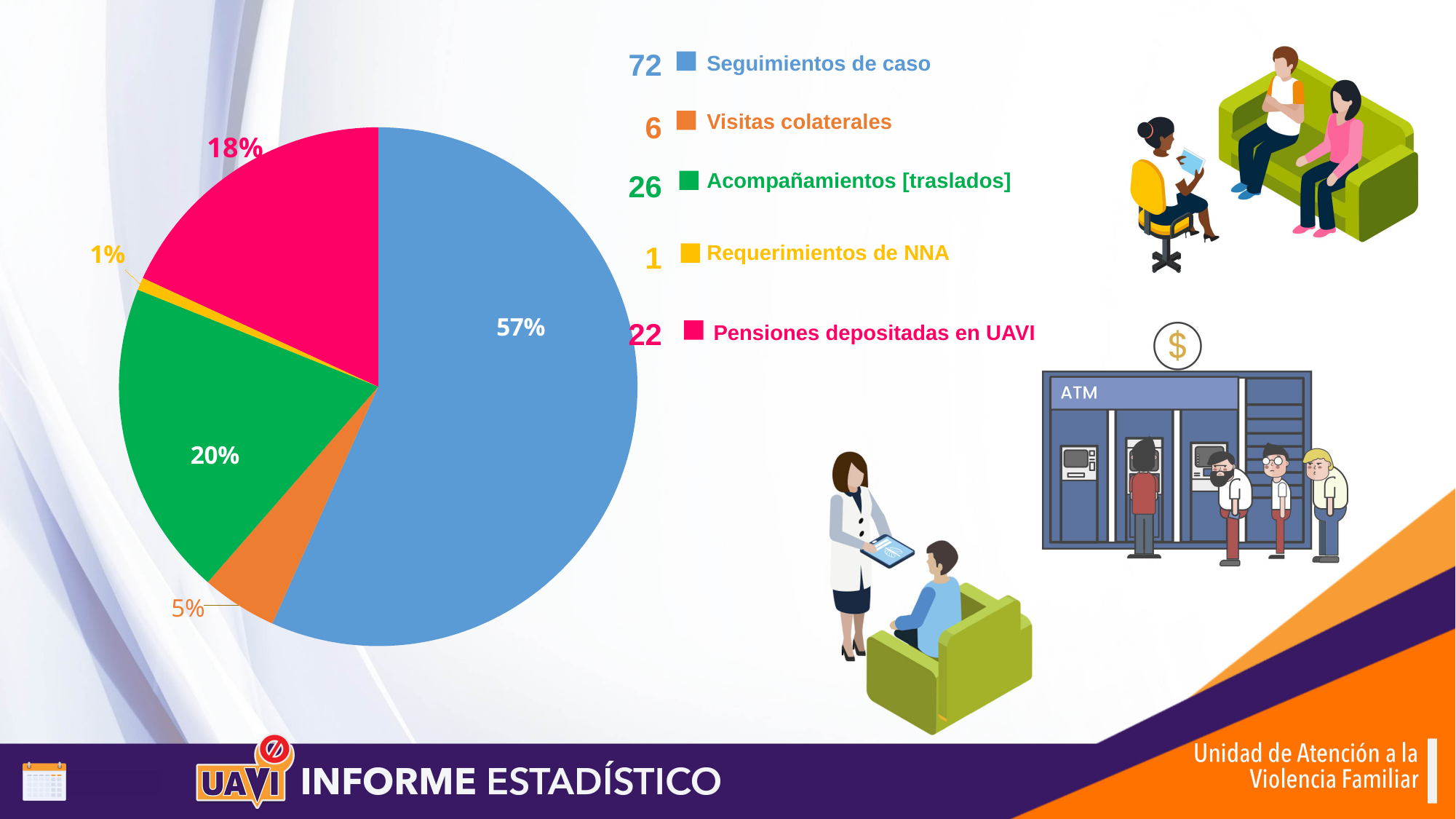
How many slices does the pie chart have? 5 What count is listed next to Seguimientos de caso in the legend? 72 What percentage share does the Pensiones depositadas en UAVI slice have? 18% What percentage share does the Seguimientos de caso slice have? 57% What is the difference in count between Seguimientos de caso and Acompañamientos [traslados]? 46 Which category has the smallest slice of the pie? Requerimientos de NNA Which category has the largest slice of the pie? Seguimientos de caso What kind of chart is shown on the slide? pie chart What percentage share does the Visitas colaterales slice have? 5% Which is larger, the Acompañamientos [traslados] slice or the Pensiones depositadas en UAVI slice? Acompañamientos [traslados] What count is listed next to Pensiones depositadas en UAVI in the legend? 22